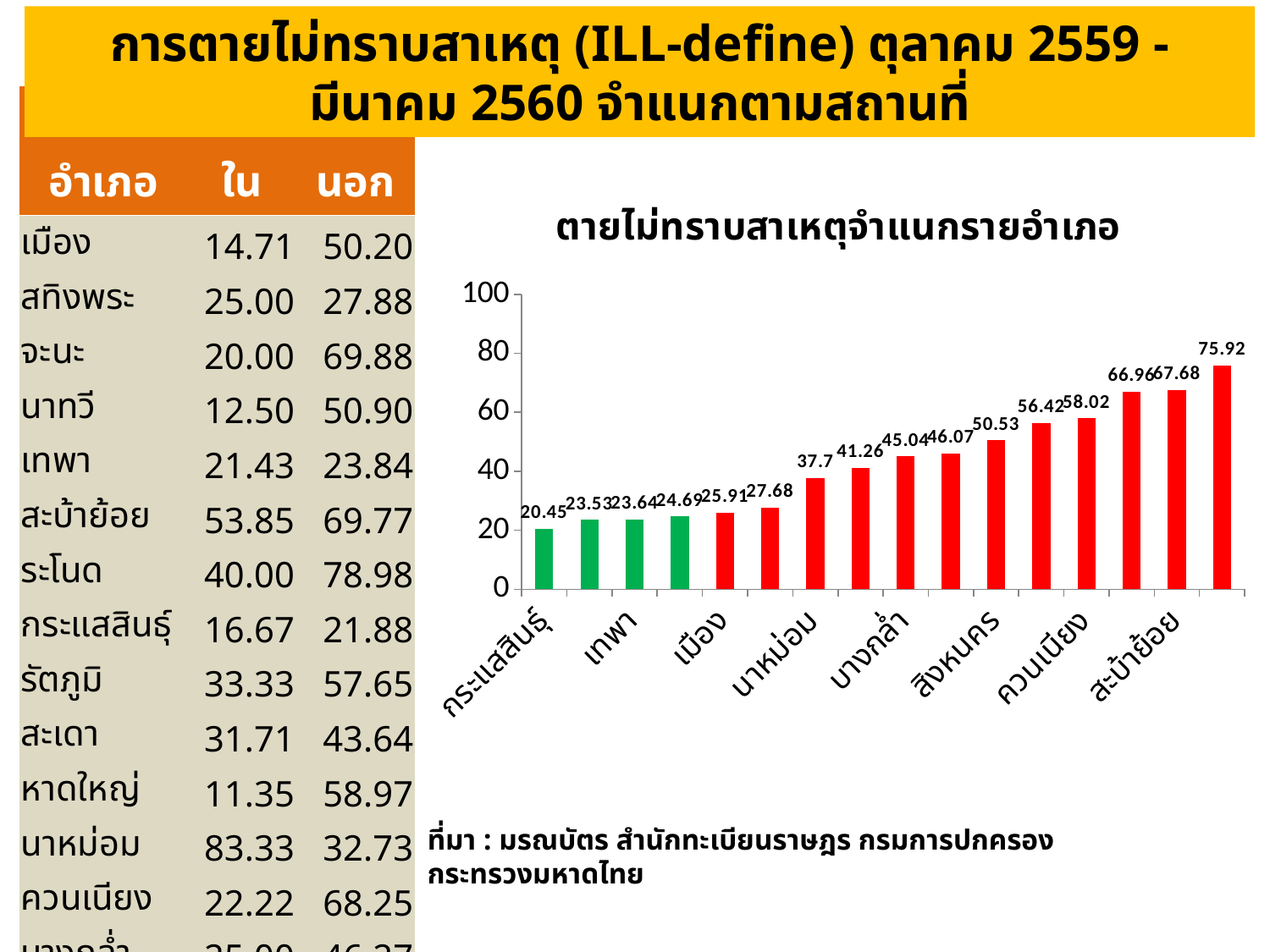
What is the value for กระแสสินธุ์ in the chart? 20.45 What is the lowest value shown in the chart? 20.45 Which district has the lowest value in the chart? กระแสสินธุ์ What type of chart is shown on the slide? bar chart How many bars in the chart are coloured green? 4 Do the values in the chart rise or fall from left to right? rise Is the value for กระแสสินธุ์ greater or less than 40? less What is the title of the chart on the slide? ตายไม่ทราบสาเหตุจำแนกรายอำเภอ How many bars are plotted in the chart? 16 What is the difference between the highest and lowest values in the chart? 55.47 What is the highest value shown in the chart? 75.92 Which is larger, the value for กระแสสินธุ์ or the value for นาหม่อม? นาหม่อม